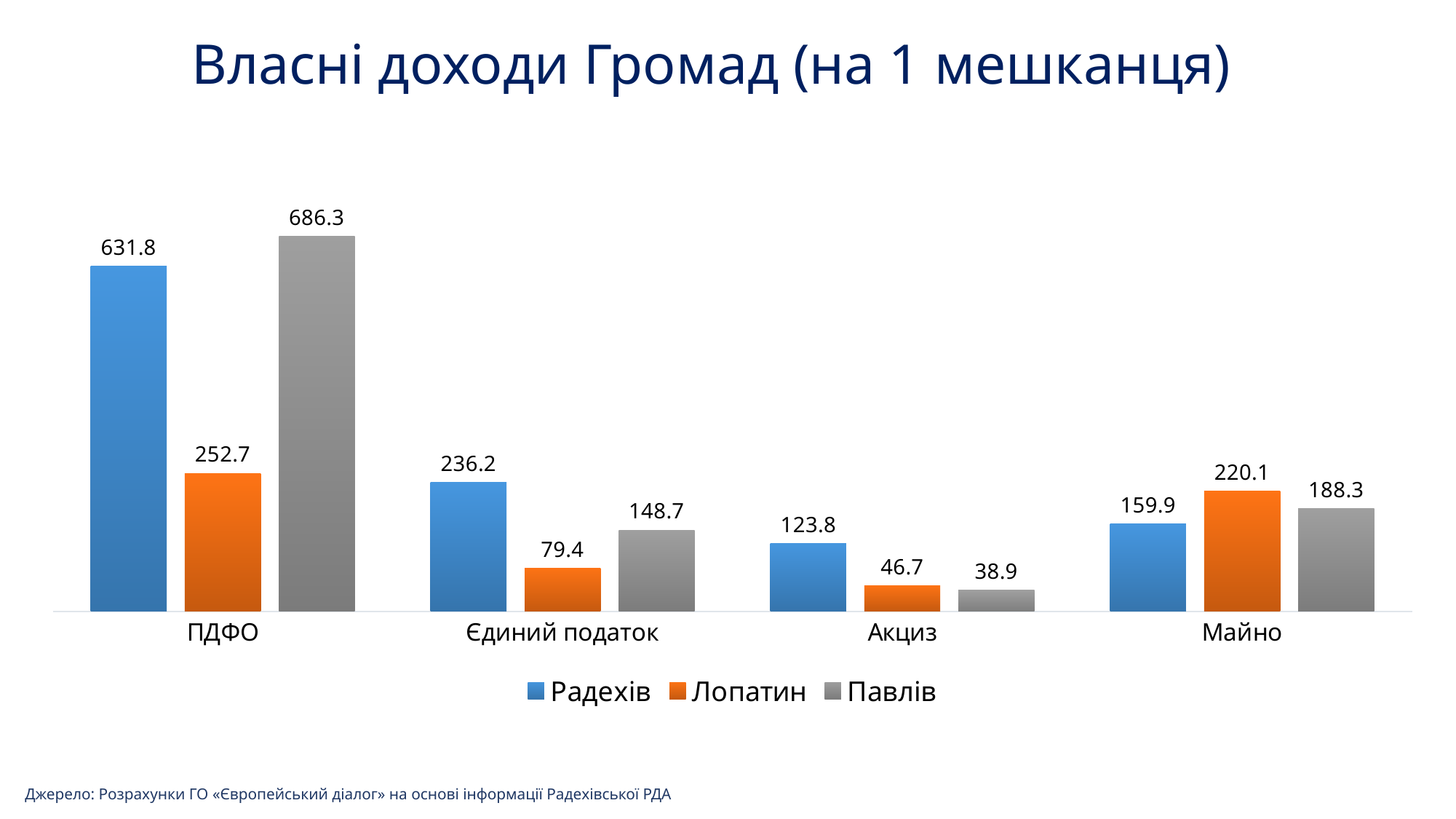
What kind of chart is shown on the slide? Bar chart Which series has the highest value in the ПДФО category? Павлів How many series does the legend list? 3 What is the value for Лопатин in the Майно category? 220.1 What is the difference between the Радехів and Лопатин values in the Акциз category? 77.1 What is the value for Радехів in the ПДФО category? 631.8 Which series has the lowest value in the Єдиний податок category? Лопатин What is the value for Павлів in the Акциз category? 38.9 Which is larger in the Майно category: Радехів or Павлів? Павлів What is the difference between the Павлів and Радехів values in the ПДФО category? 54.5 How many categories are shown on the x axis? 4 What is the title of the chart? Власні доходи Громад (на 1 мешканця)